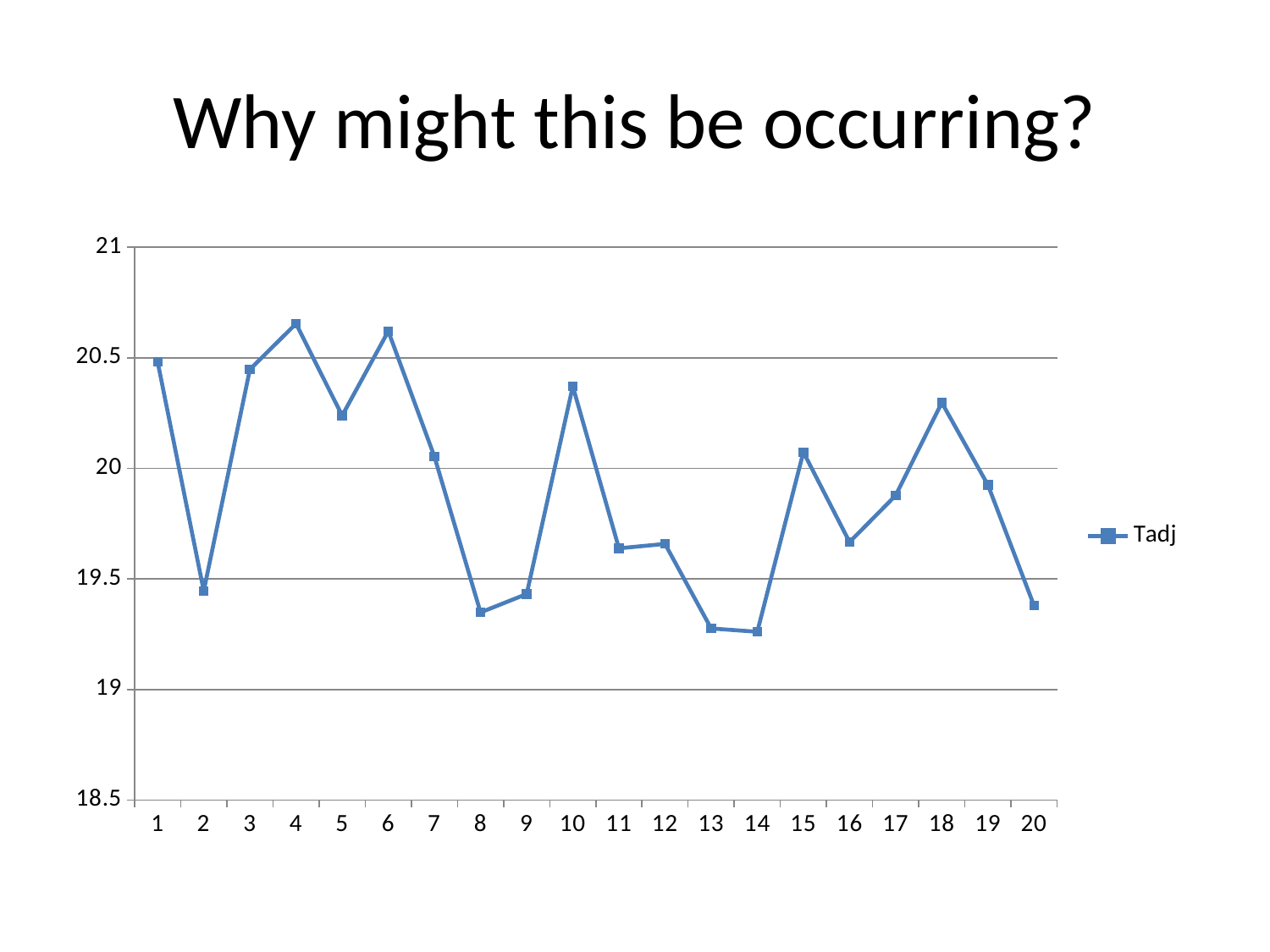
Is the Tadj value at point 13 greater or less than 19.5? less Which has the larger Tadj value, point 10 or point 13? point 10 Is the Tadj value at point 18 greater or less than 20? greater How many data points are plotted along the x axis? 20 Does the Tadj value rise or fall from point 1 to point 2? fall Is the Tadj value at point 5 greater or less than 20.5? less What is the title of the slide containing the chart? Why might this be occurring? What is the name of the series shown in the legend? Tadj What kind of chart is shown on the slide? line chart How many series does the legend list? 1